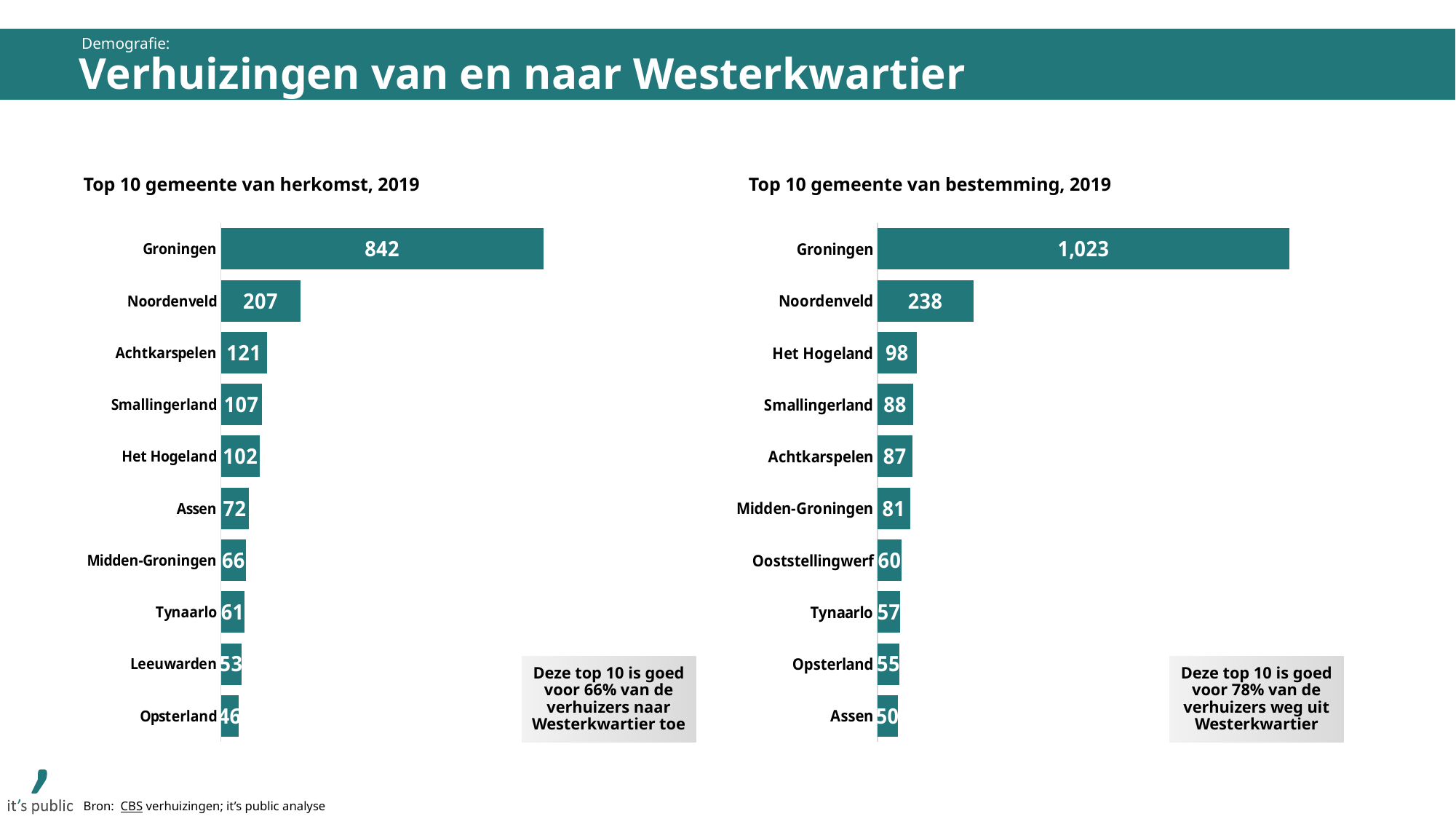
In the chart 'Top 10 gemeente van herkomst, 2019', what is the value for Smallingerland? 107 According to the note on the chart 'Top 10 gemeente van bestemming, 2019', what share of movers leaving Westerkwartier does the top 10 account for? 78% In the chart 'Top 10 gemeente van herkomst, 2019', what is the difference between Groningen and Noordenveld? 635 In the chart 'Top 10 gemeente van bestemming, 2019', what is the value for Ooststellingwerf? 60 In the chart 'Top 10 gemeente van herkomst, 2019', which is larger: Achtkarspelen or Het Hogeland? Achtkarspelen What kind of chart is 'Top 10 gemeente van herkomst, 2019'? Bar chart In the chart 'Top 10 gemeente van bestemming, 2019', what is the difference between Noordenveld and Het Hogeland? 140 In the chart 'Top 10 gemeente van herkomst, 2019', which gemeente has the lowest value? Opsterland In the chart 'Top 10 gemeente van bestemming, 2019', which gemeente has the lowest value? Assen In the chart 'Top 10 gemeente van herkomst, 2019', what is the value for Groningen? 842 How many gemeenten are shown in the chart 'Top 10 gemeente van bestemming, 2019'? 10 In the chart 'Top 10 gemeente van bestemming, 2019', what is the value for Groningen? 1,023